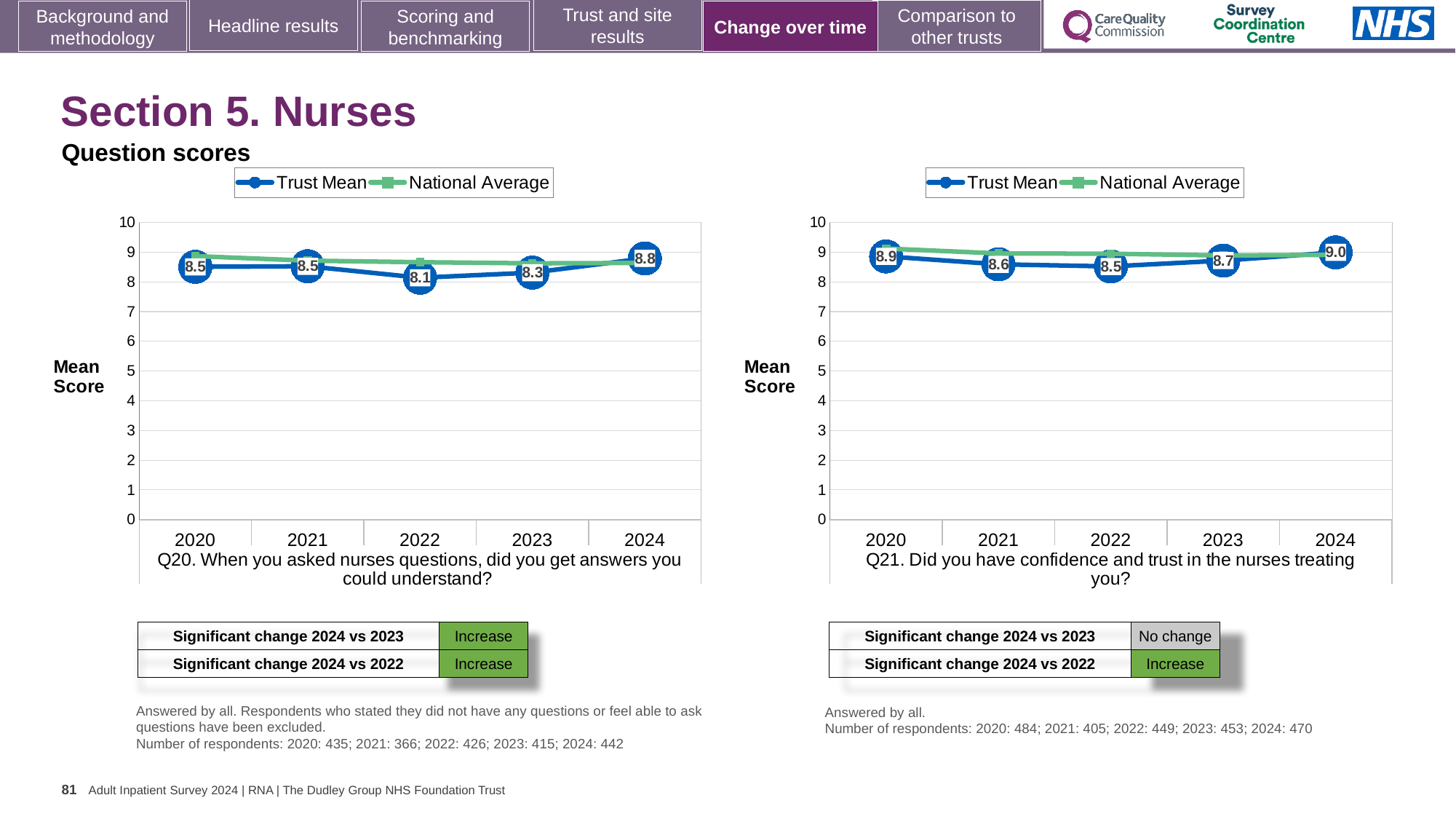
In the Q21 chart, is the Trust Mean score for 2023 larger than the Trust Mean score for 2022? Yes In the Q20 chart, which year has the lowest Trust Mean score? 2022 In the Q21 chart, which year has the highest Trust Mean score? 2024 In the Q20 chart, what is the Trust Mean score for 2024? 8.8 In the Q21 chart, what is the Trust Mean score for 2022? 8.5 How many series does the legend of the Q21 chart list? 2 In the Q21 chart, what is the difference between the Trust Mean scores for 2024 and 2021? 0.4 In the Q20 chart, what is the Trust Mean score for 2022? 8.1 In the Q20 chart, what is the difference between the Trust Mean scores for 2024 and 2022? 0.7 What kind of chart is used for Q20? Line chart In the Q21 chart, what is the Trust Mean score for 2020? 8.9 How many years are plotted on the x axis of the Q20 chart? 5